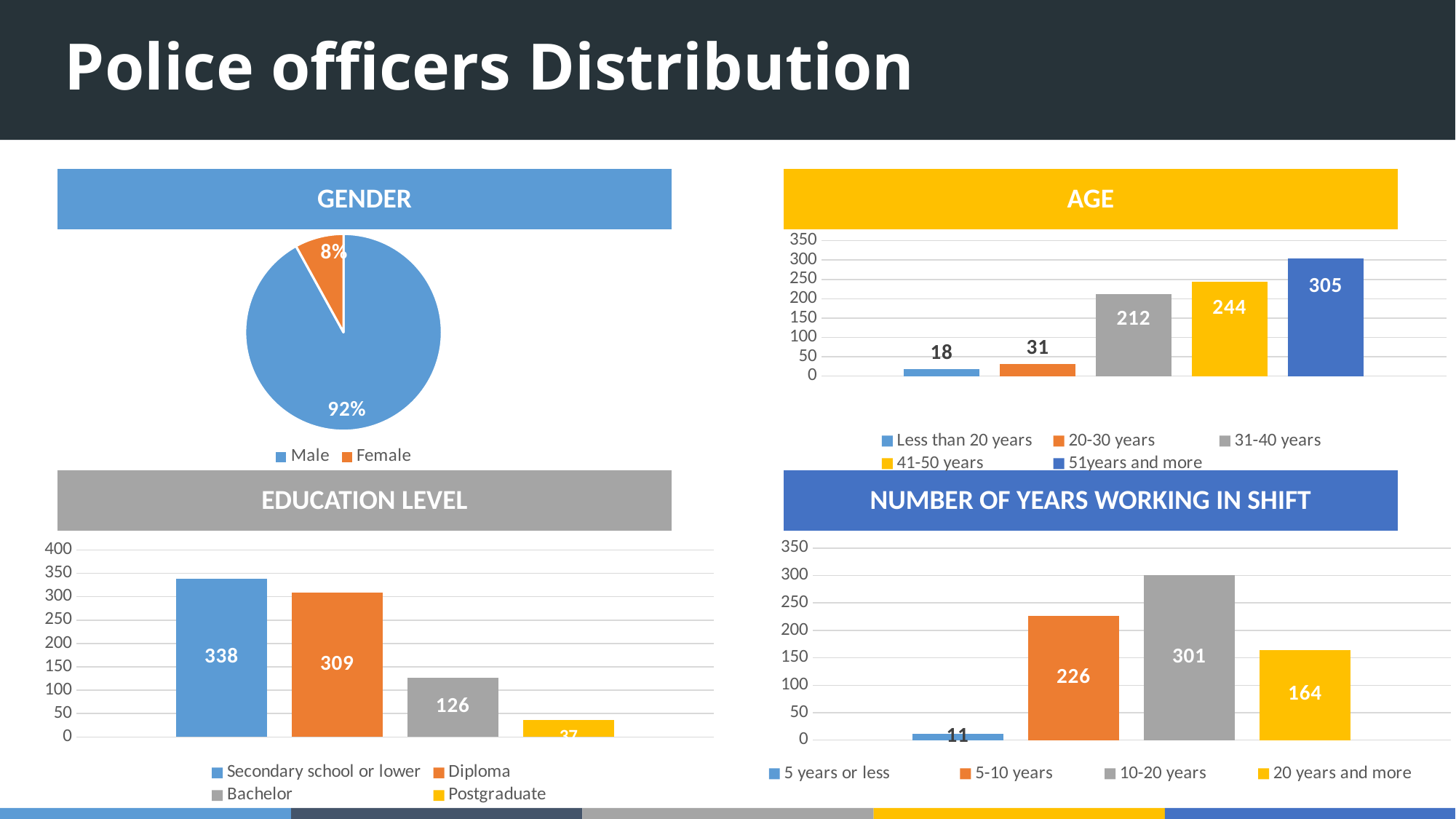
In the GENDER chart, what share of police officers are Male? 92% How many categories does the legend of the AGE chart list? 5 In the AGE chart, which age group has the lowest value? Less than 20 years In the NUMBER OF YEARS WORKING IN SHIFT chart, what is the value for 10-20 years? 301 What kind of chart is the NUMBER OF YEARS WORKING IN SHIFT chart? bar chart In the AGE chart, which age group has the highest value? 51years and more In the NUMBER OF YEARS WORKING IN SHIFT chart, what is the difference between the values for 5-10 years and 20 years and more? 62 In the EDUCATION LEVEL chart, what is the value for Diploma? 309 In the AGE chart, what is the difference between the values for 51years and more and 41-50 years? 61 In the EDUCATION LEVEL chart, which is larger, Secondary school or lower or Bachelor? Secondary school or lower In the AGE chart, what is the value for 31-40 years? 212 What kind of chart is the GENDER chart? pie chart